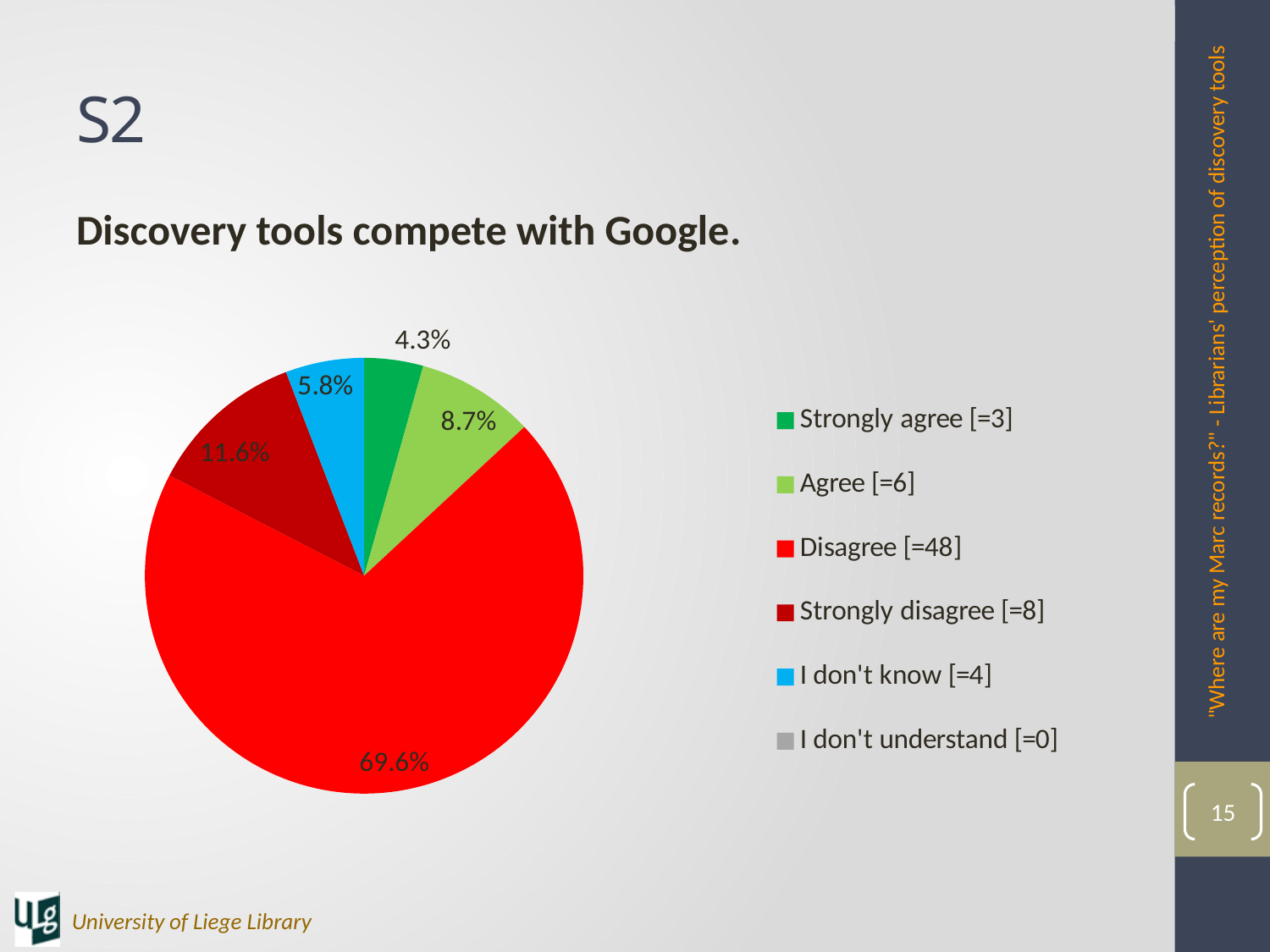
Which category with a visible slice has the smallest share of the pie? Strongly agree How many respondents chose Disagree according to the legend? 48 What is the difference in percentage points between the Disagree and Strongly disagree slices? 58.0% What share of the pie does the I don't know slice represent? 5.8% What share of the pie does the Strongly agree slice represent? 4.3% What share of the pie does the Strongly disagree slice represent? 11.6% What kind of chart is shown on the slide? pie chart Which category has the largest slice of the pie? Disagree Which slice is larger, Agree or I don't know? Agree How many entries does the legend list? 6